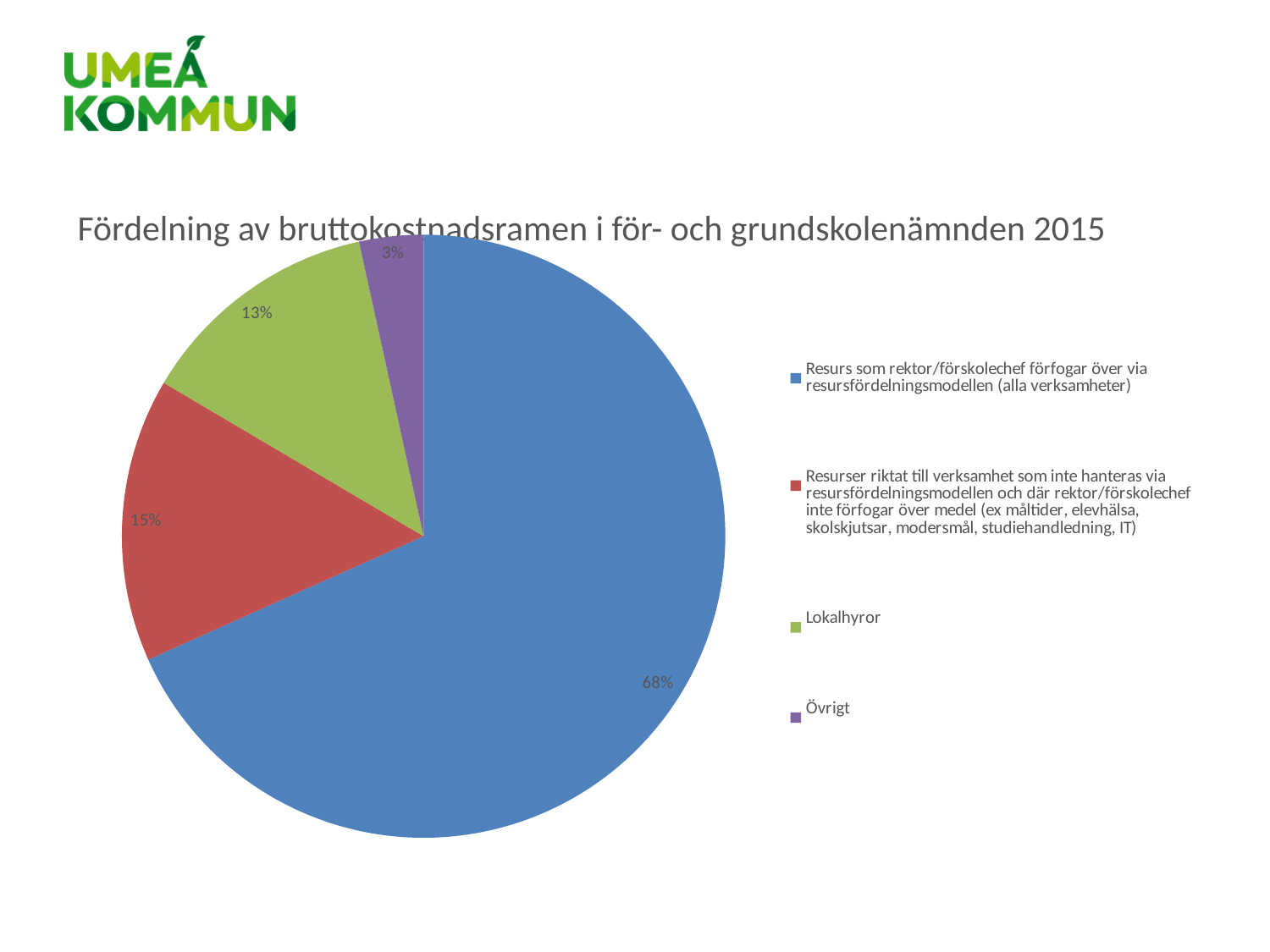
What is the difference in percentage points between the Lokalhyror slice and the Övrigt slice? 10 percentage points What share of the pie is Lokalhyror? 13% Which category has the largest slice of the pie? Resurs som rektor/förskolechef förfogar över via resursfördelningsmodellen (alla verksamheter) What share of the pie is 'Resurs som rektor/förskolechef förfogar över via resursfördelningsmodellen (alla verksamheter)'? 68% What colour is the Lokalhyror slice? Green What is the title of the chart? Fördelning av bruttokostnadsramen i för- och grundskolenämnden 2015 Which category has the smallest slice of the pie? Övrigt What kind of chart is shown on the slide? Pie chart How many categories does the pie chart have? 4 What share of the pie is 'Resurser riktat till verksamhet som inte hanteras via resursfördelningsmodellen och där rektor/förskolechef inte förfogar över medel'? 15% Which is larger: the Lokalhyror slice or the slice for resources directed to activities not handled via the resource allocation model (15%)? The 15% slice (Resurser riktat till verksamhet som inte hanteras via resursfördelningsmodellen)